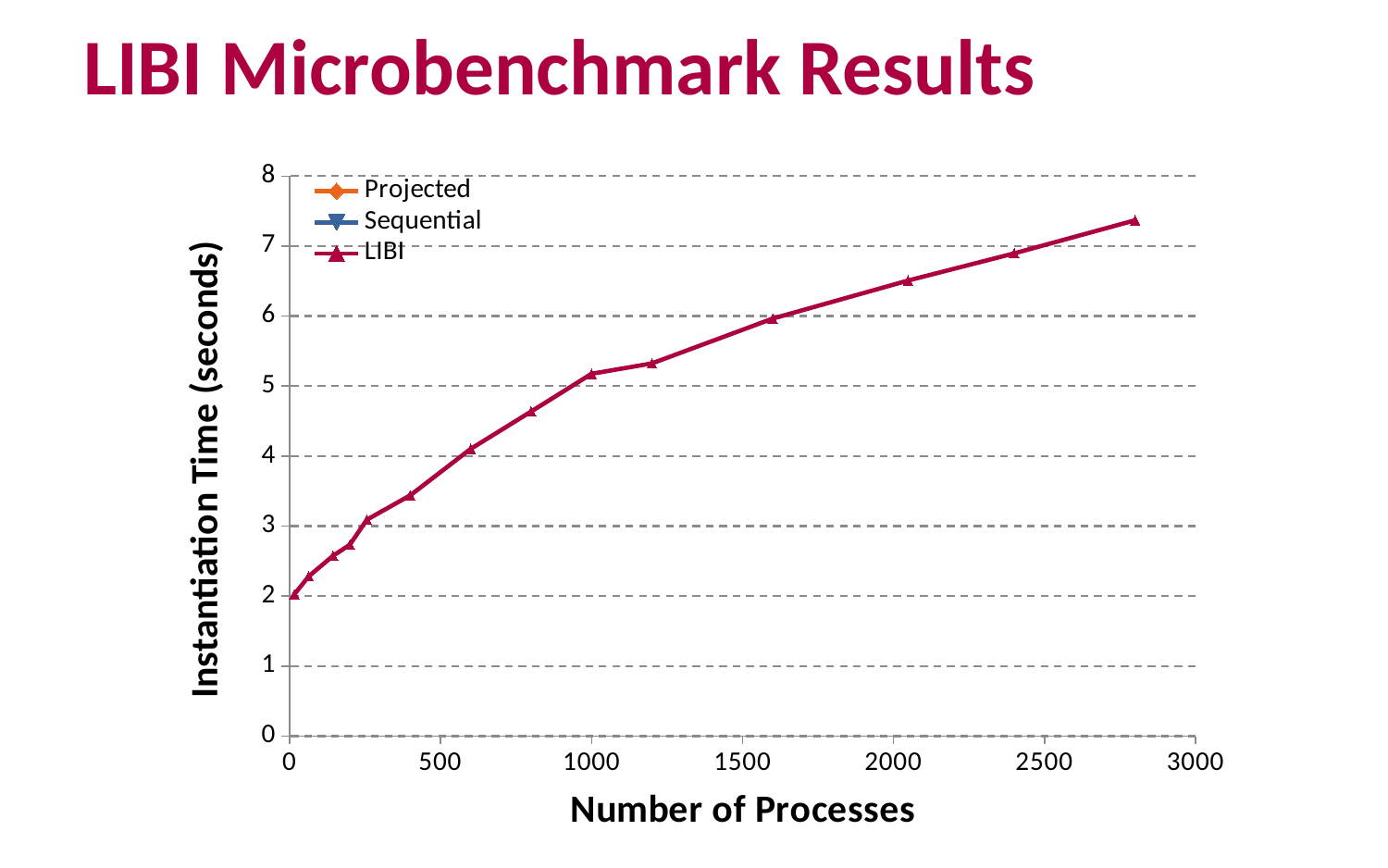
How many series does the legend list? 3 Is the LIBI instantiation time at 400 processes greater or less than 4 seconds? less Does the LIBI instantiation time rise or fall as the number of processes increases? rise Which series are listed in the legend? Projected, Sequential, LIBI What is the title of the chart? LIBI Microbenchmark Results Which is larger, the LIBI instantiation time at 800 processes or at 1600 processes? 1600 processes Is the LIBI instantiation time at 2400 processes greater or less than 6 seconds? greater Is the LIBI instantiation time at 600 processes greater or less than 5 seconds? less At which number of processes is the LIBI instantiation time highest? 2800 What kind of chart is shown on the slide? line chart